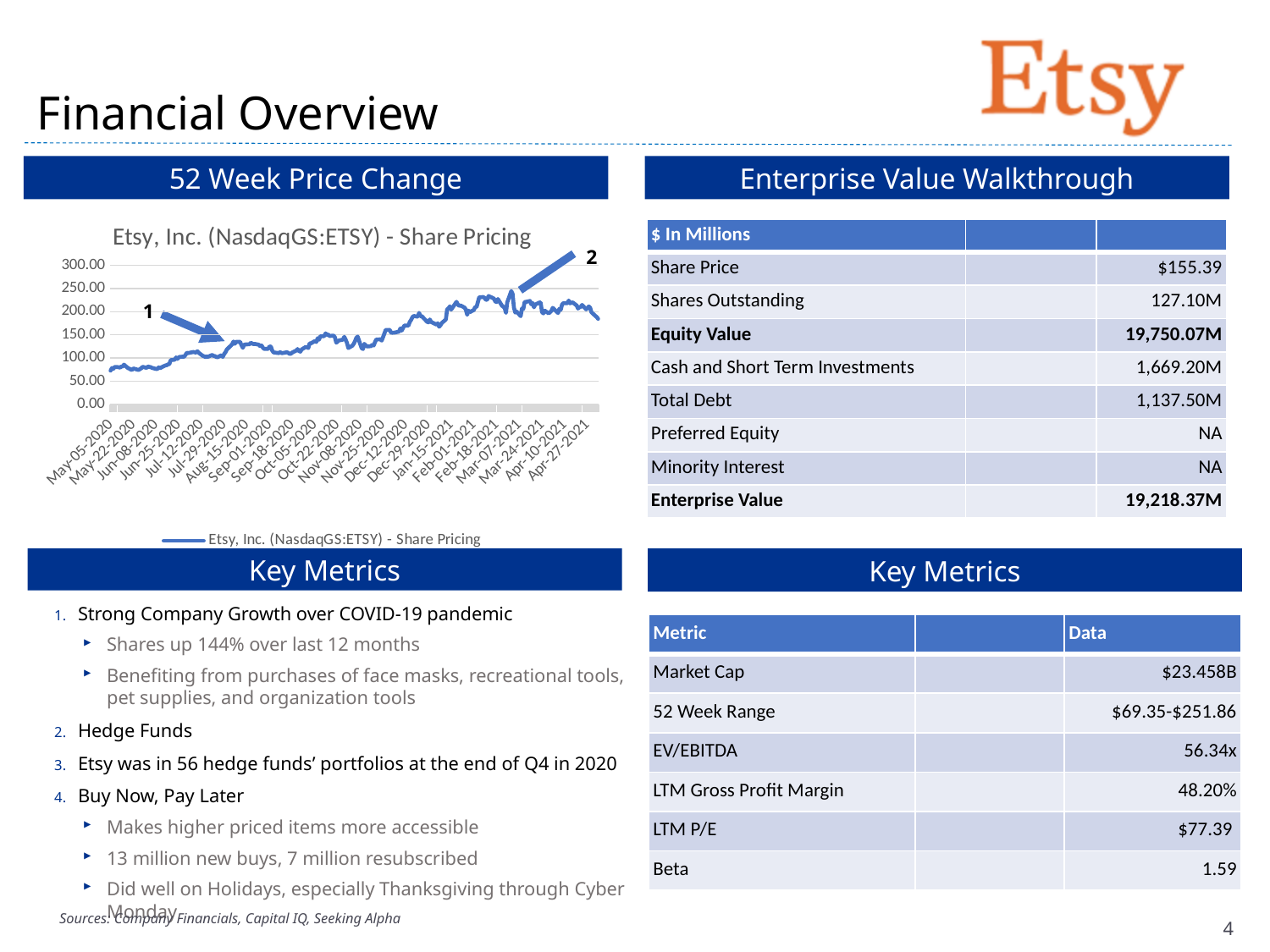
Is the share price at Apr-27-2021 greater or less than 150.00? greater Is the highest share price reached on the chart greater or less than 200.00? greater Is the share price at May-05-2020 greater or less than 150.00? less How many series does the legend of the share pricing chart list? 1 What is the highest value shown on the y axis of the share pricing chart? 300.00 Which date has the higher share price on the chart, May-05-2020 or Apr-27-2021? Apr-27-2021 What kind of chart is shown under the '52 Week Price Change' heading? line chart What is the title of the chart on the slide? Etsy, Inc. (NasdaqGS:ETSY) - Share Pricing Does the share price in the chart generally rise or fall from May-05-2020 to Apr-27-2021? rise Which date has the higher share price on the chart, Jul-12-2020 or Jan-15-2021? Jan-15-2021